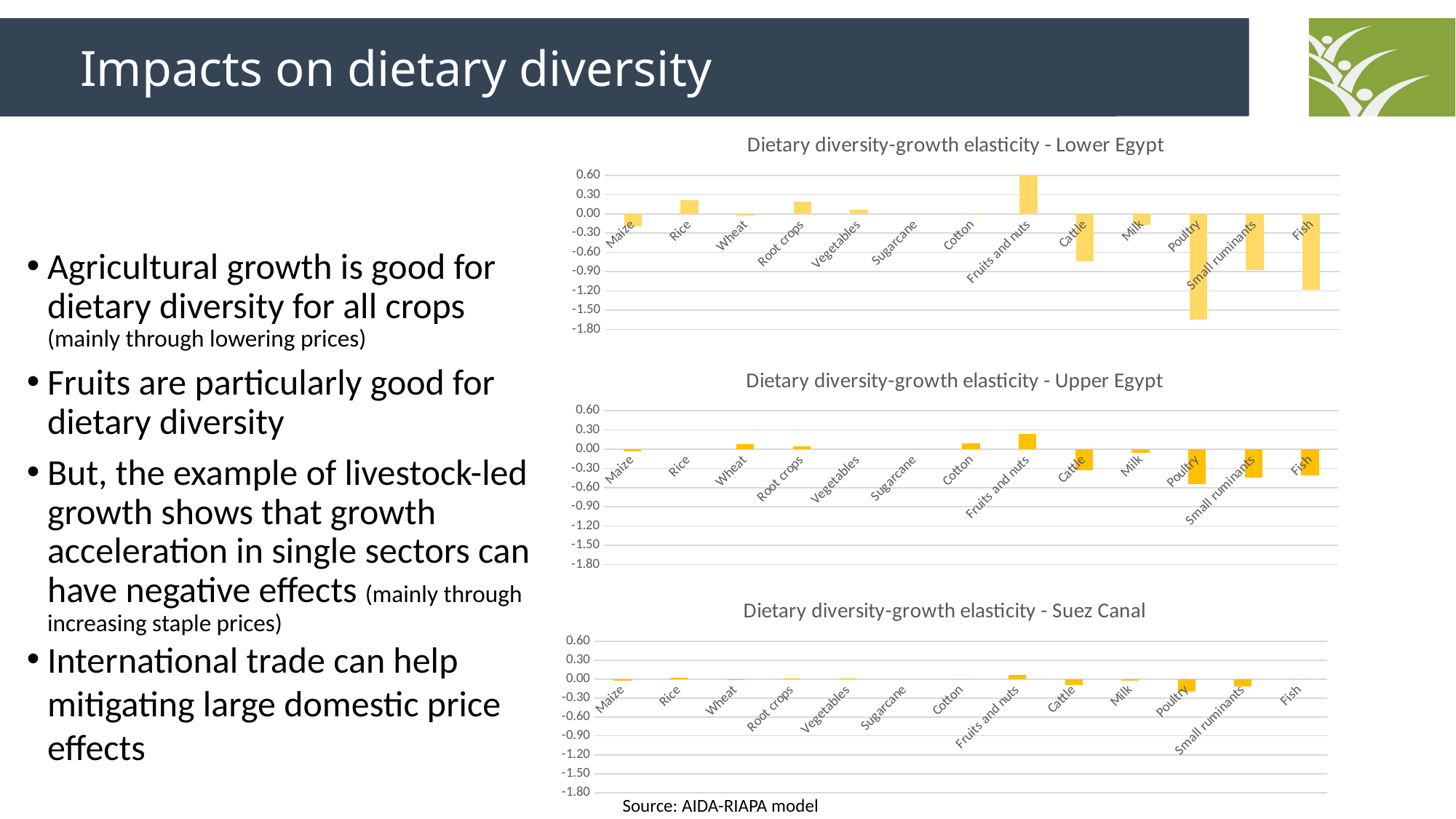
In the 'Dietary diversity-growth elasticity - Lower Egypt' chart, is the value for Poultry greater or less than -1.50? less In the 'Dietary diversity-growth elasticity - Suez Canal' chart, which category has the lowest value? Poultry What is the title of the top chart on the slide? Dietary diversity-growth elasticity - Lower Egypt In the 'Dietary diversity-growth elasticity - Upper Egypt' chart, is the value for Poultry greater or less than -0.30? less How many categories are shown on the x axis of the 'Dietary diversity-growth elasticity - Upper Egypt' chart? 13 What kind of chart is the 'Dietary diversity-growth elasticity - Lower Egypt' chart? Bar chart In the 'Dietary diversity-growth elasticity - Lower Egypt' chart, is the value for Fish greater or less than -0.90? less In the 'Dietary diversity-growth elasticity - Upper Egypt' chart, which category has the highest value? Fruits and nuts In the 'Dietary diversity-growth elasticity - Lower Egypt' chart, which category has the highest value? Fruits and nuts In the 'Dietary diversity-growth elasticity - Lower Egypt' chart, which category has the lowest value? Poultry In the 'Dietary diversity-growth elasticity - Upper Egypt' chart, which category has the lowest value? Poultry